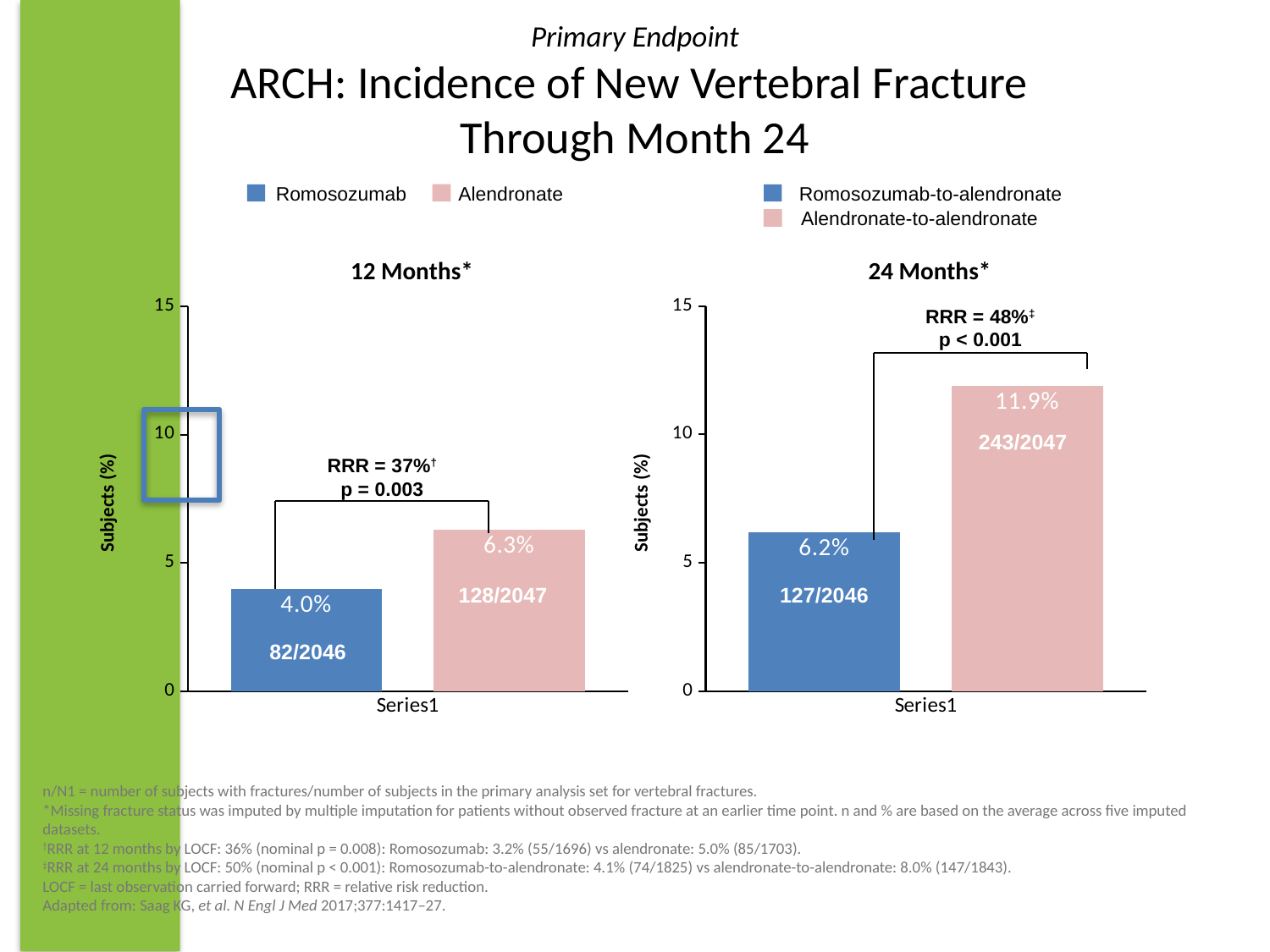
In the 24 Months chart, what is the difference between the Alendronate-to-alendronate and Romosozumab-to-alendronate values? 5.7% In the 12 Months chart, what is the value for Romosozumab? 4.0% How many series does the legend of the 24 Months chart list? 2 In the 12 Months chart, what is the RRR shown above the bars? 37% In the 12 Months chart, which series has the lower value? Romosozumab What kind of chart is the 12 Months chart? Bar chart In the 24 Months chart, which series has the higher value? Alendronate-to-alendronate In the 12 Months chart, what is the value for Alendronate? 6.3% In the 12 Months chart, what is the difference between the Alendronate and Romosozumab values? 2.3% In the 24 Months chart, what is the value for Alendronate-to-alendronate? 11.9% In the 24 Months chart, what is the value for Romosozumab-to-alendronate? 6.2% In the 24 Months chart, is the value for Alendronate-to-alendronate greater or less than 10? greater